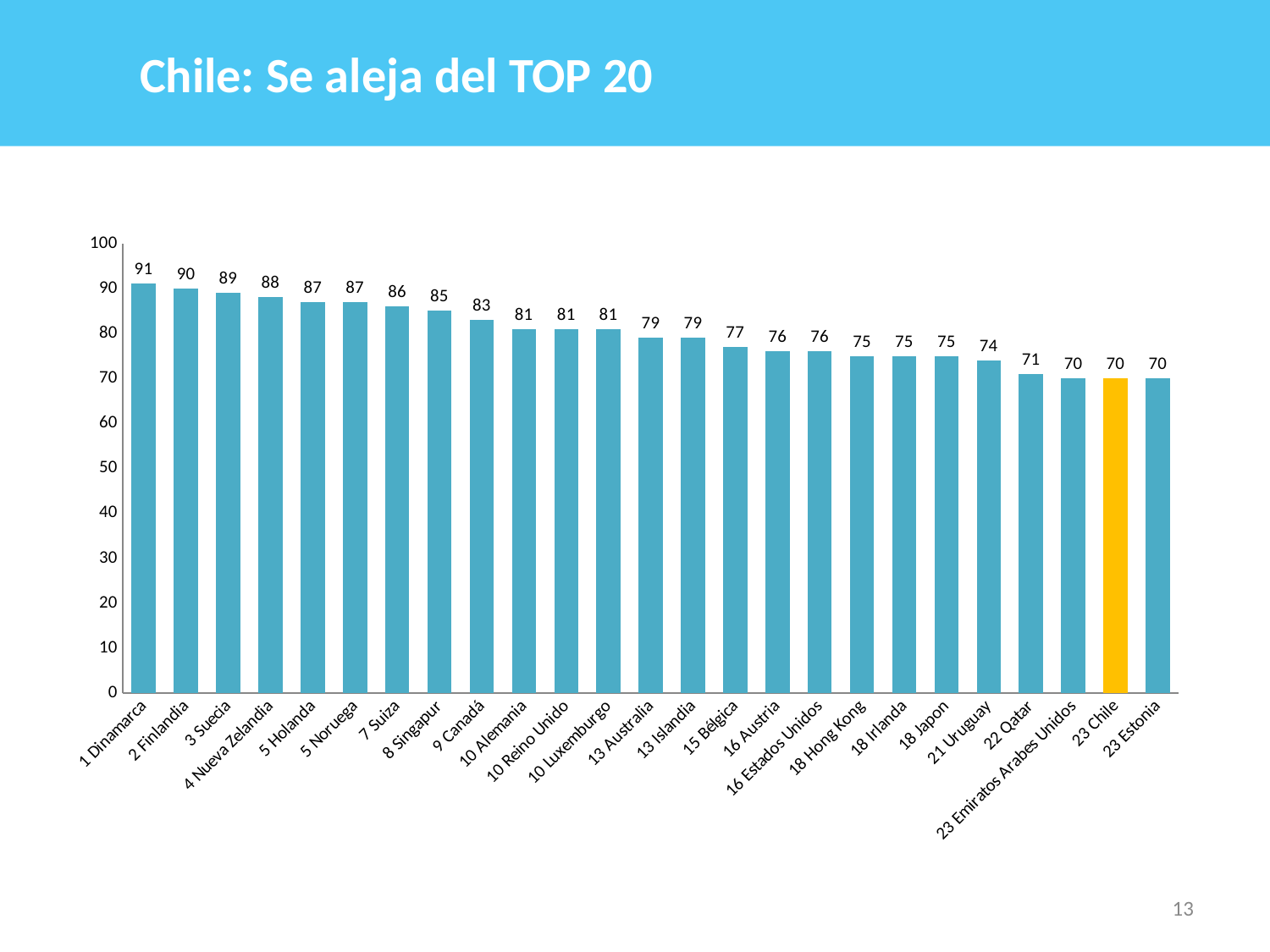
Do the values rise or fall moving from left to right along the x axis? Fall Which country has the highest value in the chart? 1 Dinamarca What is the value shown for 23 Chile? 70 Which has a larger value, 7 Suiza or 13 Australia? 7 Suiza What is the value shown for 1 Dinamarca? 91 What is the lowest value shown in the chart? 70 What is the value shown for 21 Uruguay? 74 What is the difference between the values for 1 Dinamarca and 23 Chile? 21 Which bar is highlighted in a different colour (yellow) from the others? 23 Chile How many countries (bars) are shown in the chart? 25 What kind of chart is shown on the slide? Bar chart What is the difference between the values for 9 Canadá and 15 Bélgica? 6